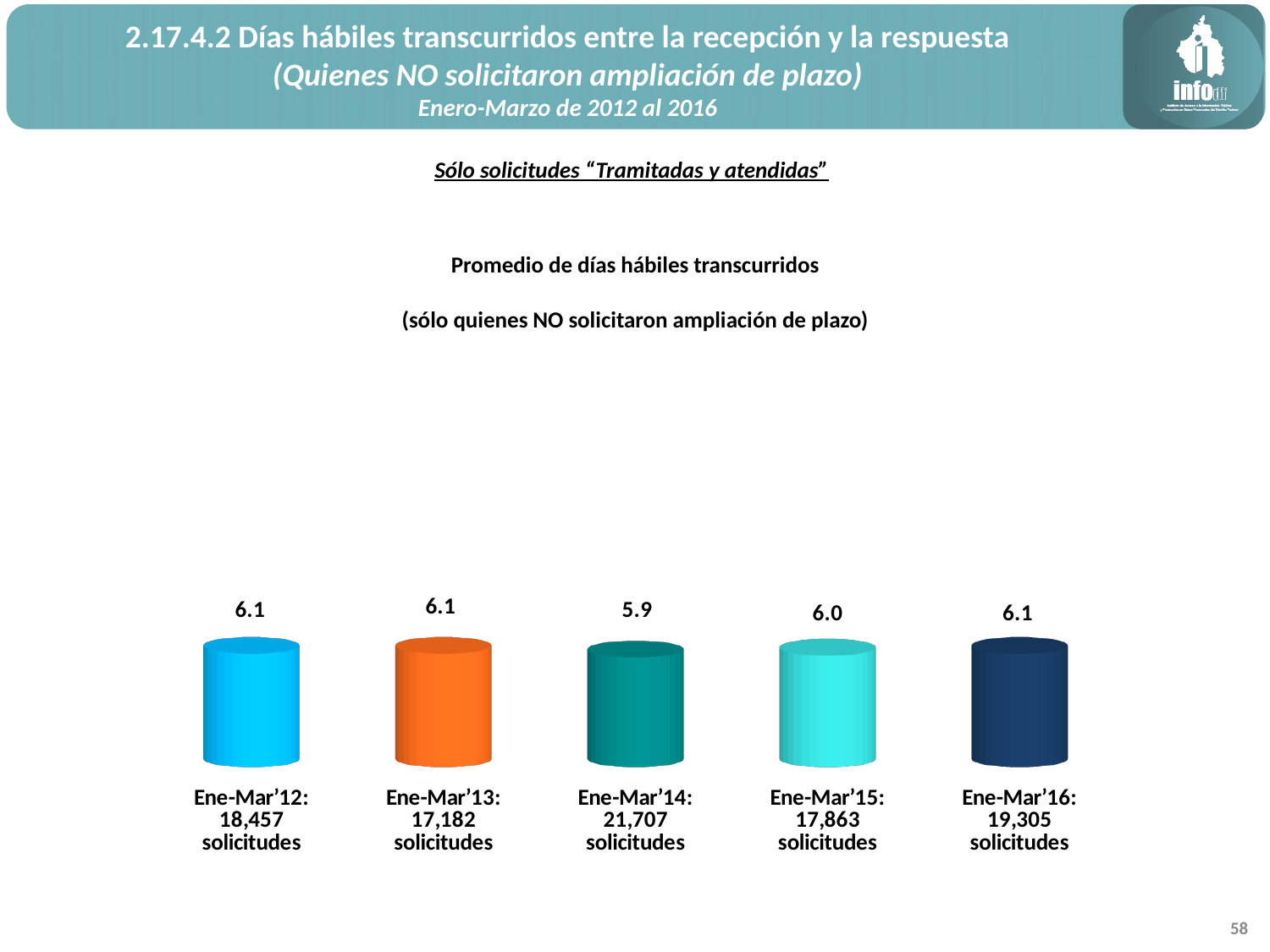
How many solicitudes are listed for Ene-Mar'16? 19,305 What is the average number of business days for Ene-Mar'12? 6.1 How many solicitudes are listed for Ene-Mar'14? 21,707 What is the average number of business days for Ene-Mar'15? 6.0 How many periods are shown in the chart? 5 Which period has the lowest average number of business days? Ene-Mar'14 What is the average number of business days for Ene-Mar'14? 5.9 What is the title of the chart? Promedio de días hábiles transcurridos (sólo quienes NO solicitaron ampliación de plazo) What colour is the bar for Ene-Mar'13? Orange Which is larger, the value for Ene-Mar'14 or the value for Ene-Mar'15? Ene-Mar'15 What is the difference between the values for Ene-Mar'12 and Ene-Mar'14? 0.2 What kind of chart is shown on the slide? Bar chart